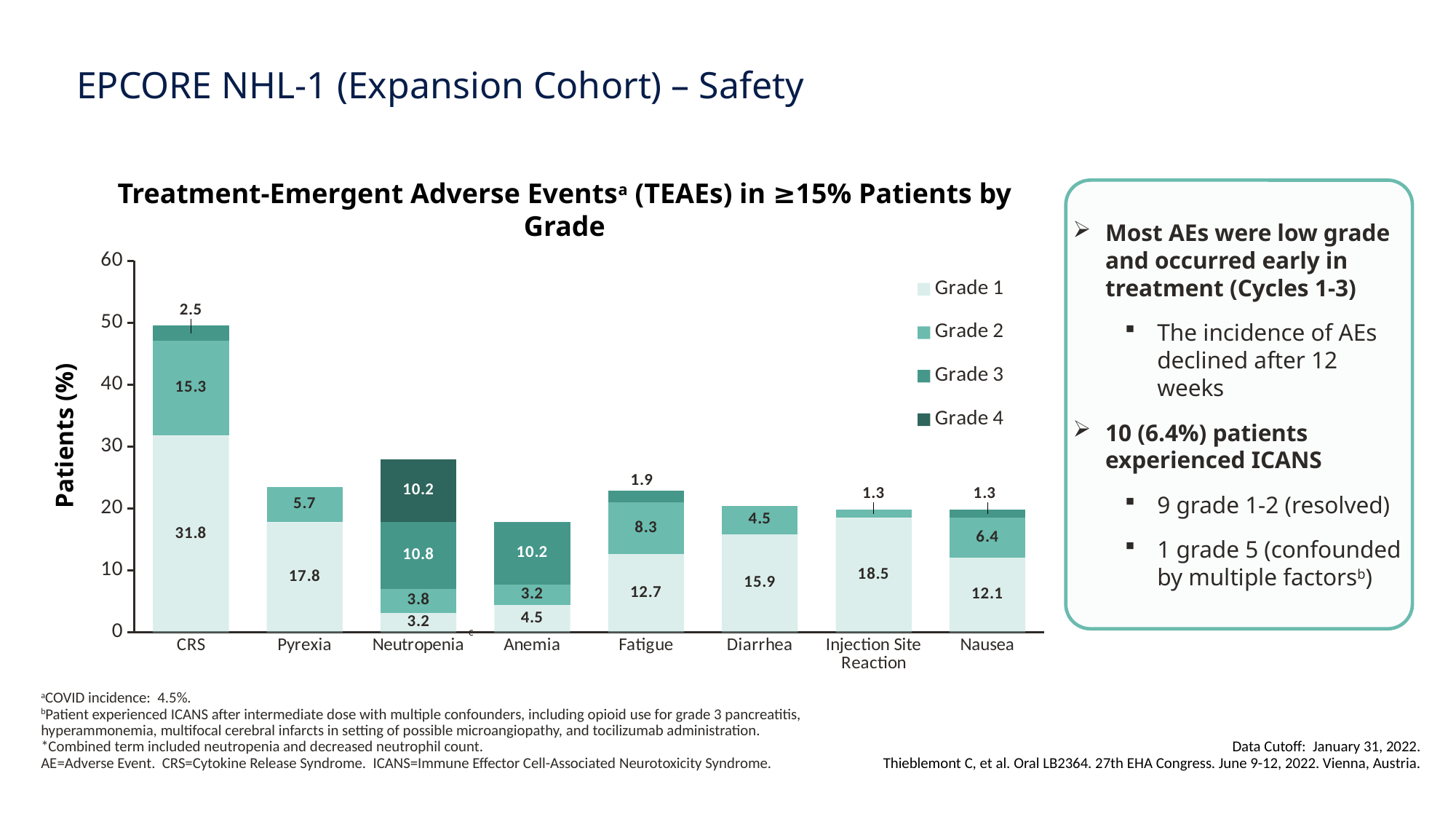
What kind of chart is shown? Stacked bar chart What is the difference between the Grade 1 value for CRS and the Grade 1 value for Pyrexia? 14.0 What is the Grade 1 value for Injection Site Reaction? 18.5 Which has the larger Grade 2 value, Fatigue or Nausea? Fatigue How many adverse event categories are shown on the x axis? 8 What is the Grade 4 value for Neutropenia? 10.2 How many series does the legend list? 4 Which adverse event has the highest total bar? CRS What is the Grade 1 value for CRS? 31.8 What is the total of the stacked bar for Neutropenia? 28.0 Is the total bar for CRS greater or less than 40? greater What is the Grade 2 value for Pyrexia? 5.7